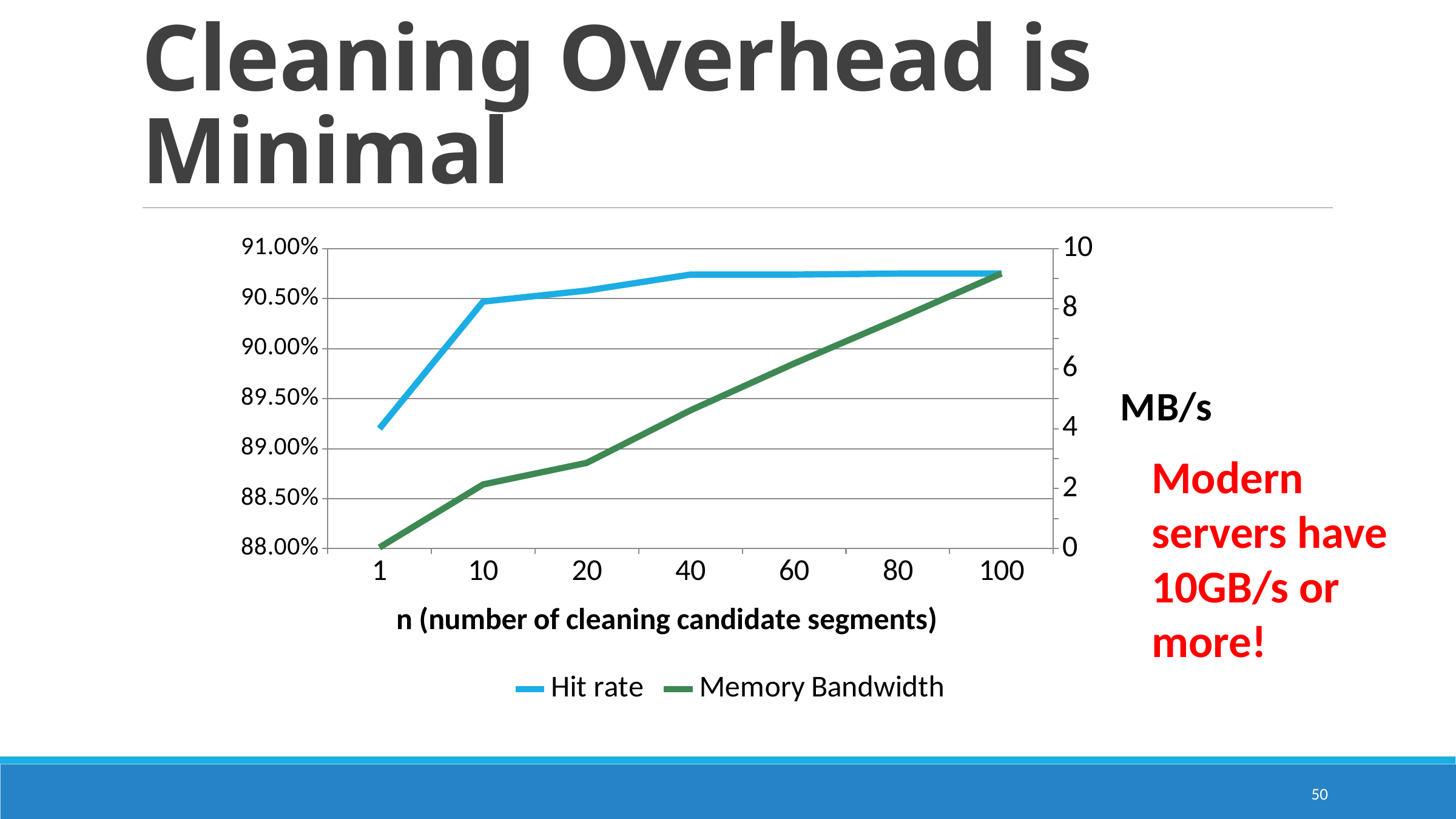
Is the Hit rate at n = 1 greater or less than 89.50%? less What kind of chart is shown on the slide? line chart How many values of n are plotted along the x axis? 7 At which value of n is Memory Bandwidth lowest? 1 Is the Memory Bandwidth at n = 20 greater or less than 4 MB/s? less What is the label of the x axis? n (number of cleaning candidate segments) At which value of n is Memory Bandwidth highest? 100 Does the Memory Bandwidth rise or fall as n increases from 1 to 100? rise Is the Memory Bandwidth at n = 100 greater or less than 8 MB/s? greater At which value of n is the Hit rate lowest? 1 How many series does the legend list? 2